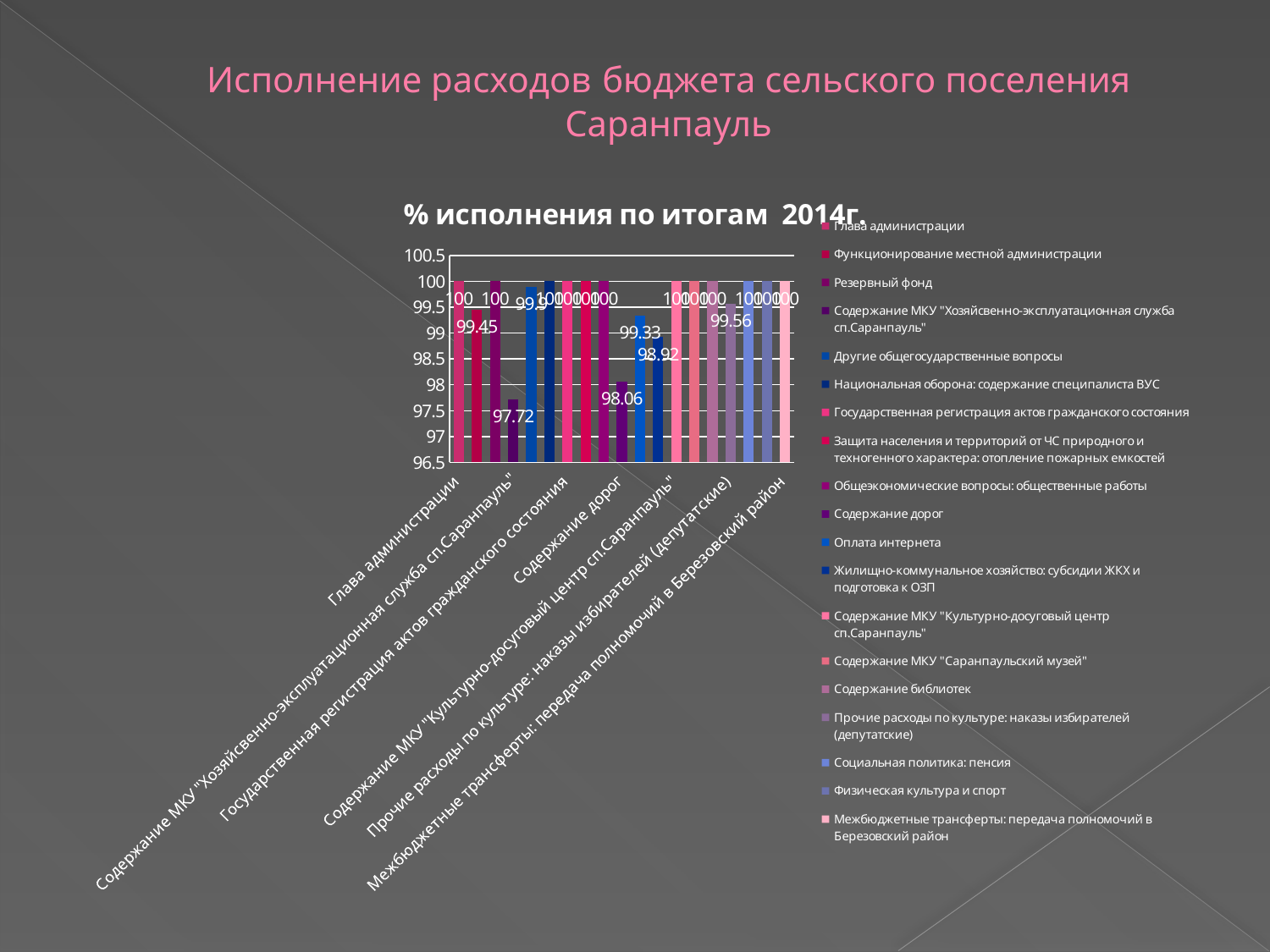
What type of chart is shown on the slide? bar chart What is the value for Межбюджетные трансферты: передача полномочий в Березовский район? 100 What is the value for Оплата интернета? 99.33 What is the title of the chart? % исполнения по итогам 2014г. Is the value for Жилищно-коммунальное хозяйство: субсидии ЖКХ и подготовка к ОЗП greater or less than 99? less Which series has the lowest value? Содержание МКУ "Хозяйсвенно-эксплуатационная служба сп.Саранпауль" What is the difference between the value for Глава администрации and the value for Содержание МКУ "Хозяйсвенно-эксплуатационная служба сп.Саранпауль"? 2.28 How many series does the legend list? 19 What is the value for Прочие расходы по культуре: наказы избирателей (депутатские)? 99.56 Which is larger, the value for Содержание дорог or the value for Оплата интернета? Оплата интернета What is the value for Функционирование местной администрации? 99.45 What is the value for Содержание дорог? 98.06